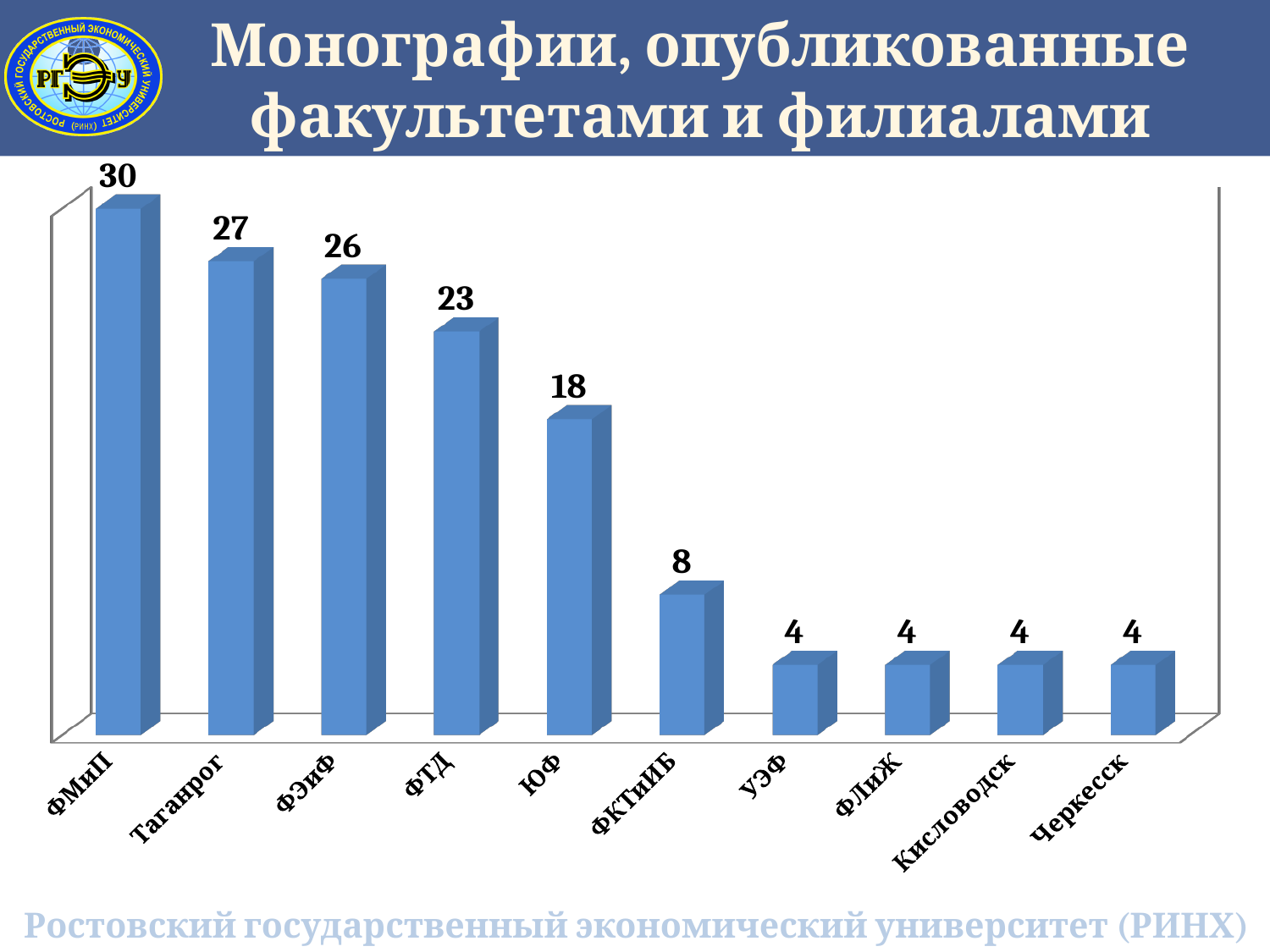
What is the difference between the values for ФЭиФ and ЮФ? 8 What kind of chart is shown on the slide? bar chart What is the value for ФКТиИБ? 8 Do the values rise or fall from left to right along the x axis? fall What is the title of the chart? Монографии, опубликованные факультетами и филиалами What is the difference between the values for ФМиП and ФТД? 7 Which is larger, the value for Таганрог or the value for ФЭиФ? Таганрог What is the value for ФМиП? 30 Which category has the highest value? ФМиП What is the value for ЮФ? 18 What is the value for Таганрог? 27 How many categories are shown on the chart? 10